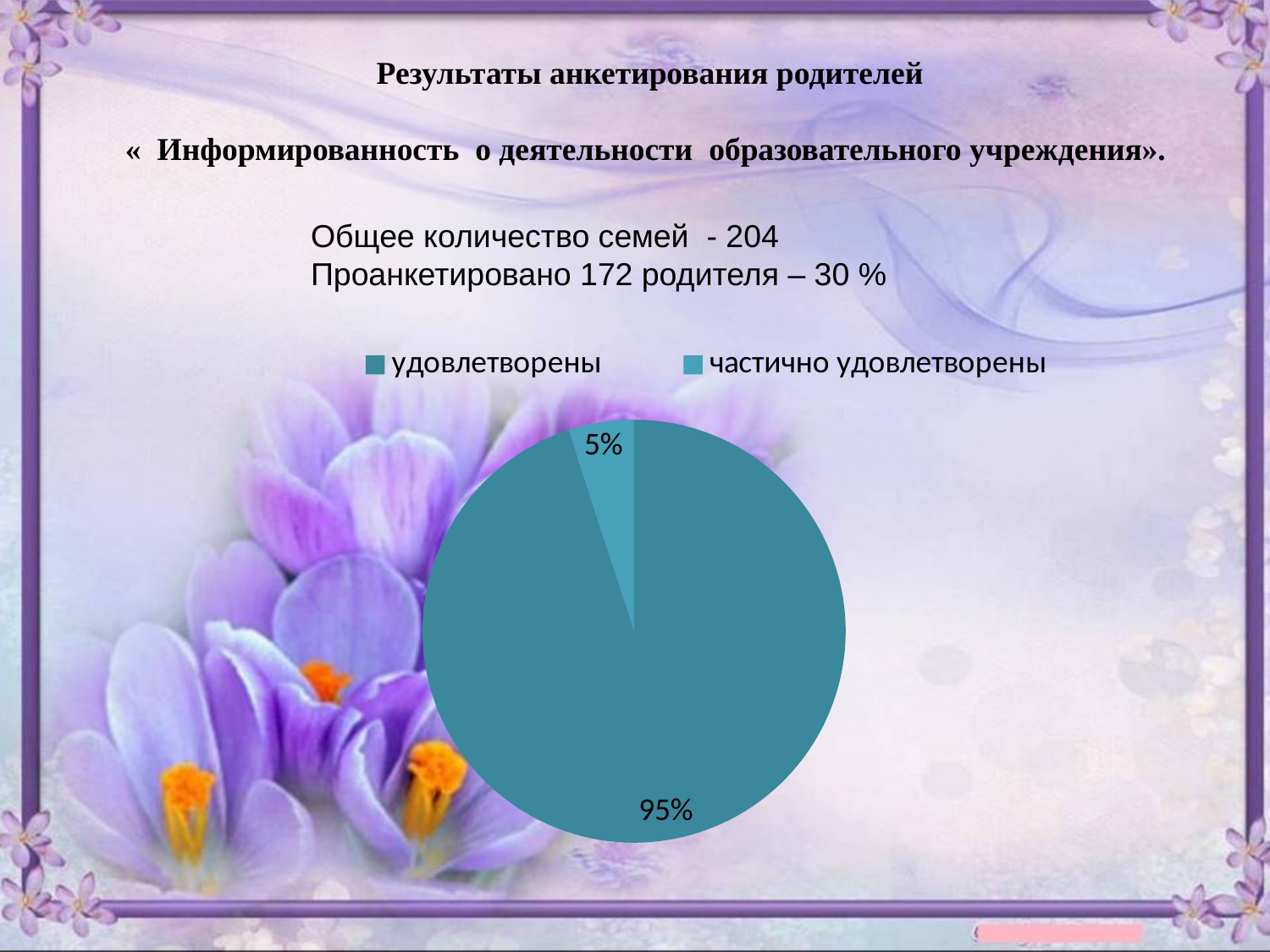
Where is the legend positioned relative to the pie? above the pie What share of the pie is labelled "частично удовлетворены"? 5% Which legend entry is shown in the lighter teal colour? частично удовлетворены Which is larger: the share for "удовлетворены" or for "частично удовлетворены"? удовлетворены What is the total of the two slice percentages shown on the pie? 100% How many slices does the pie chart have? 2 How many entries does the legend list? 2 Which category has the smallest slice of the pie? частично удовлетворены What kind of chart is shown on the slide? pie chart What share of the pie is labelled "удовлетворены"? 95% Which category has the largest slice of the pie? удовлетворены What is the difference between the "удовлетворены" and "частично удовлетворены" shares? 90%